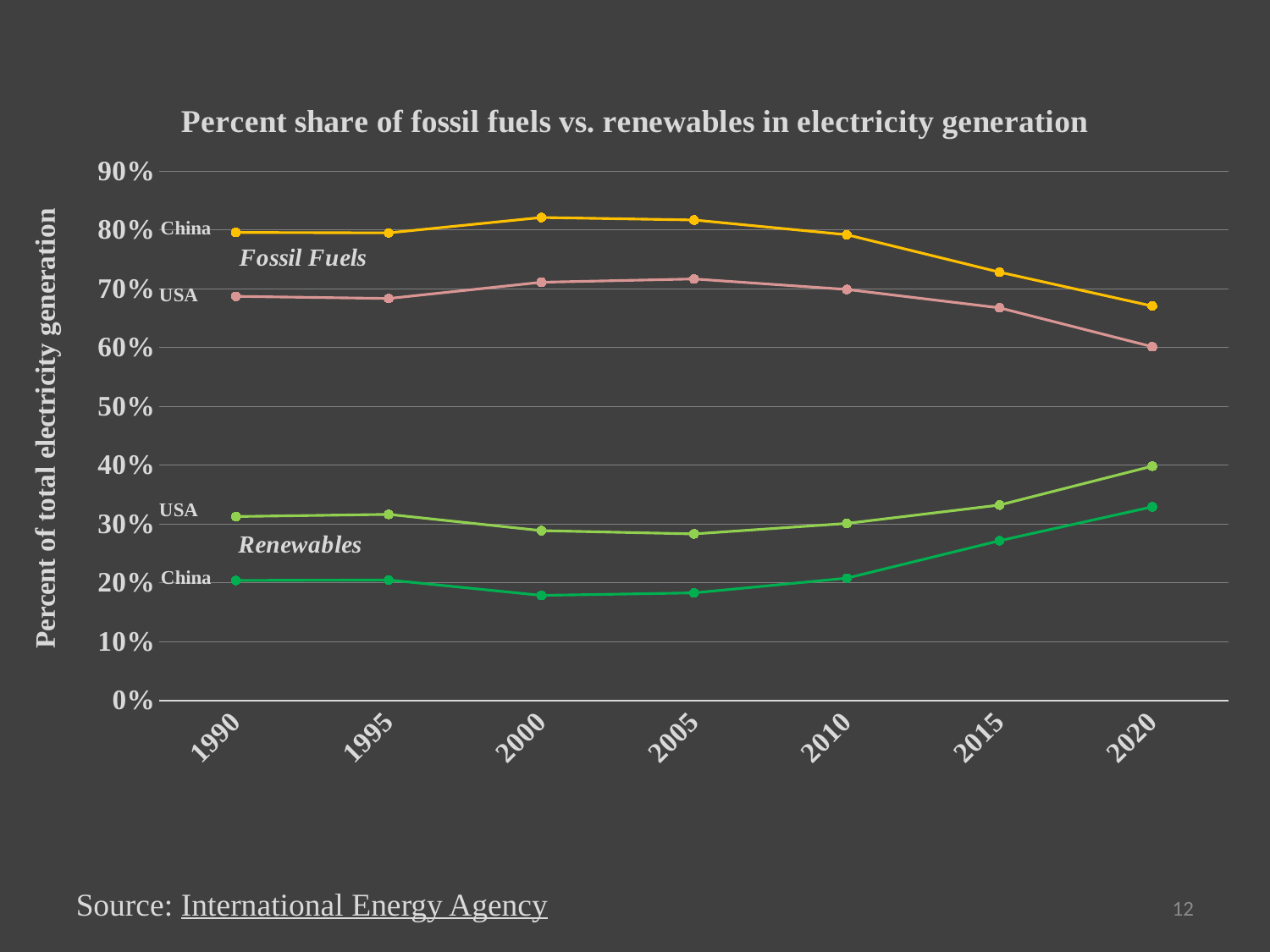
Does the China Renewables line rise or fall from 2005 to 2020? Rise What is the label on the vertical axis of the chart? Percent of total electricity generation Which series has the lowest value in 2000? China Renewables What is the title of the chart? Percent share of fossil fuels vs. renewables in electricity generation Is the China Fossil Fuels value in 2020 greater or less than 70%? less Is the China Renewables value in 2000 greater or less than 20%? less What kind of chart is shown on the slide? Line chart Is the China Renewables value in 2020 greater or less than 30%? greater Which series has the highest value in 1990? China Fossil Fuels How many years are shown along the x axis of the chart? 7 How many data series (lines) are plotted on the chart? 4